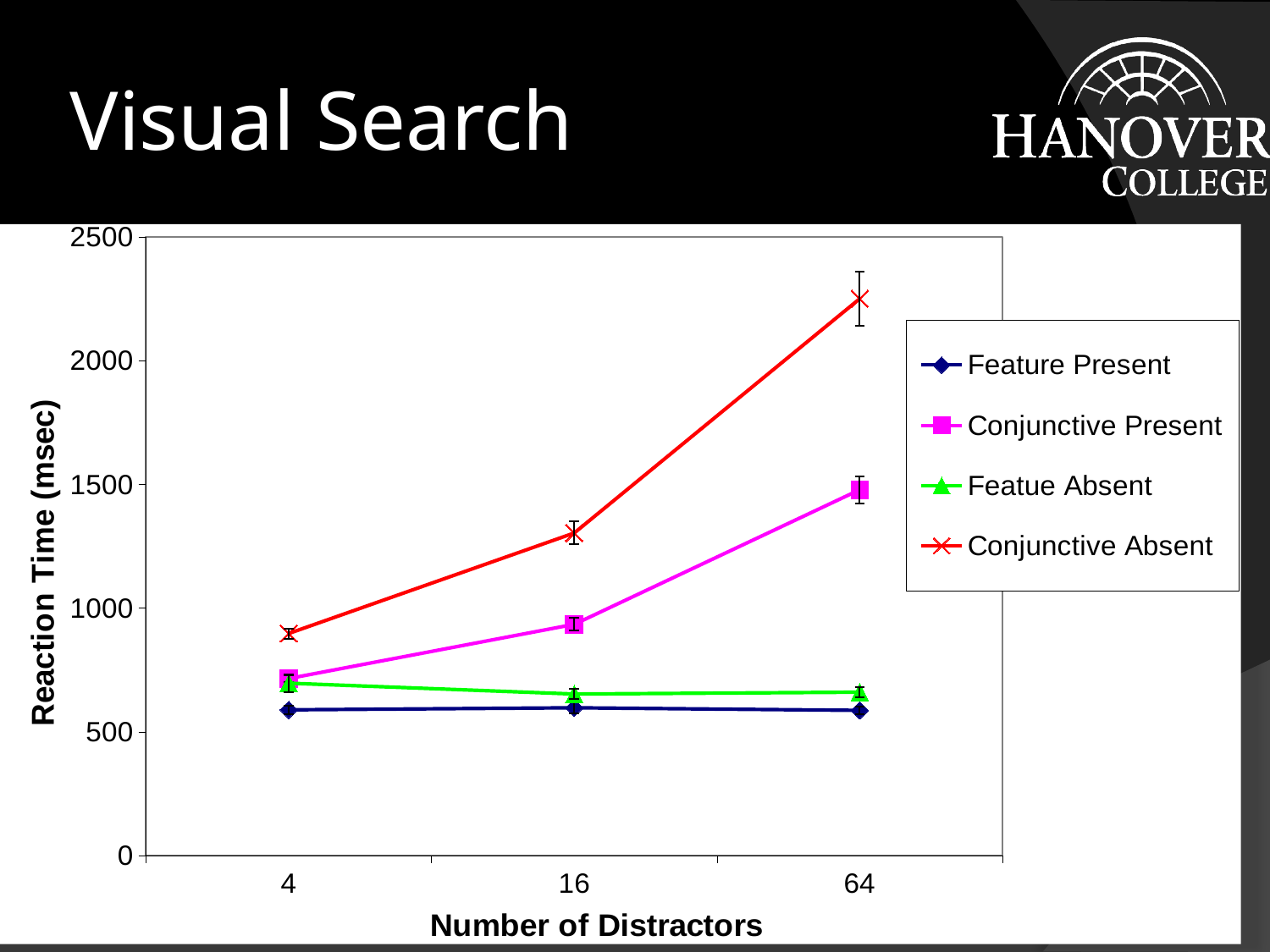
Is the value for Conjunctive Present at 16 distractors greater or less than 1000? less At 16 distractors, which is larger: Conjunctive Present or Featue Absent? Conjunctive Present Does the Conjunctive Absent series rise or fall as the number of distractors increases? rise Which series has the lowest reaction time at 64 distractors? Feature Present Is the value for Conjunctive Absent at 16 distractors greater or less than 1000? greater What kind of chart is shown on the slide? line chart What is the label of the y axis? Reaction Time (msec) Which series has the highest reaction time at 64 distractors? Conjunctive Absent Is the value for Conjunctive Absent at 4 distractors greater or less than 1000? less How many values of Number of Distractors are plotted on the x axis? 3 How many series does the legend list? 4